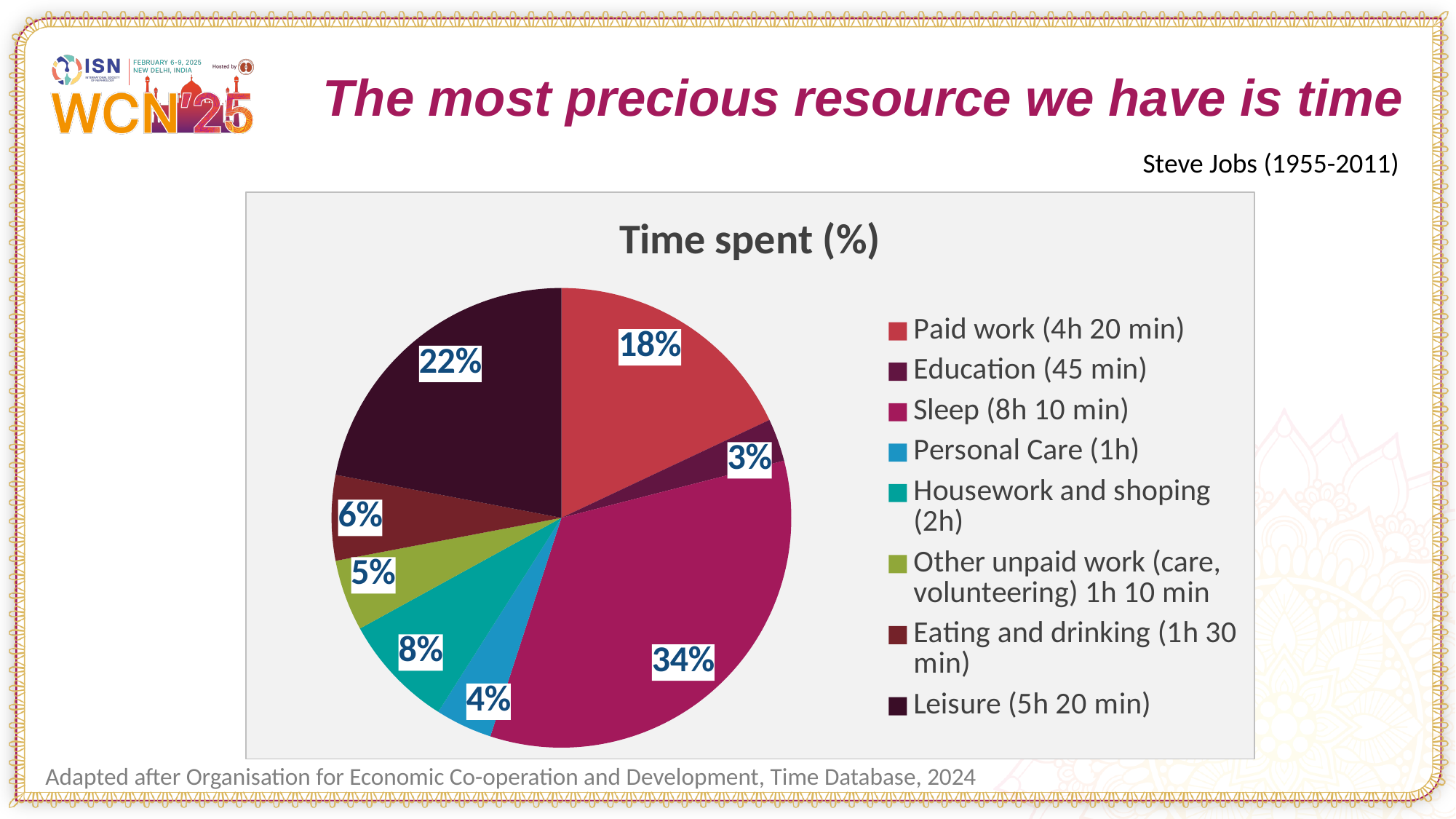
Which has a larger share of time, Eating and drinking or Personal Care? Eating and drinking What percentage of time is spent on Paid work? 18% What type of chart is shown on the slide? pie chart Which category has the largest share of time spent? Sleep What percentage of time is spent on Education? 3% How many categories does the legend list? 8 What percentage of time is spent on Leisure? 22% What is the title of the chart? Time spent (%) What percentage of time is spent on Sleep? 34% What is the difference in percentage points between Sleep and Leisure? 12 Which category has the smallest share of time spent? Education What percentage of time is spent on Housework and shoping? 8%